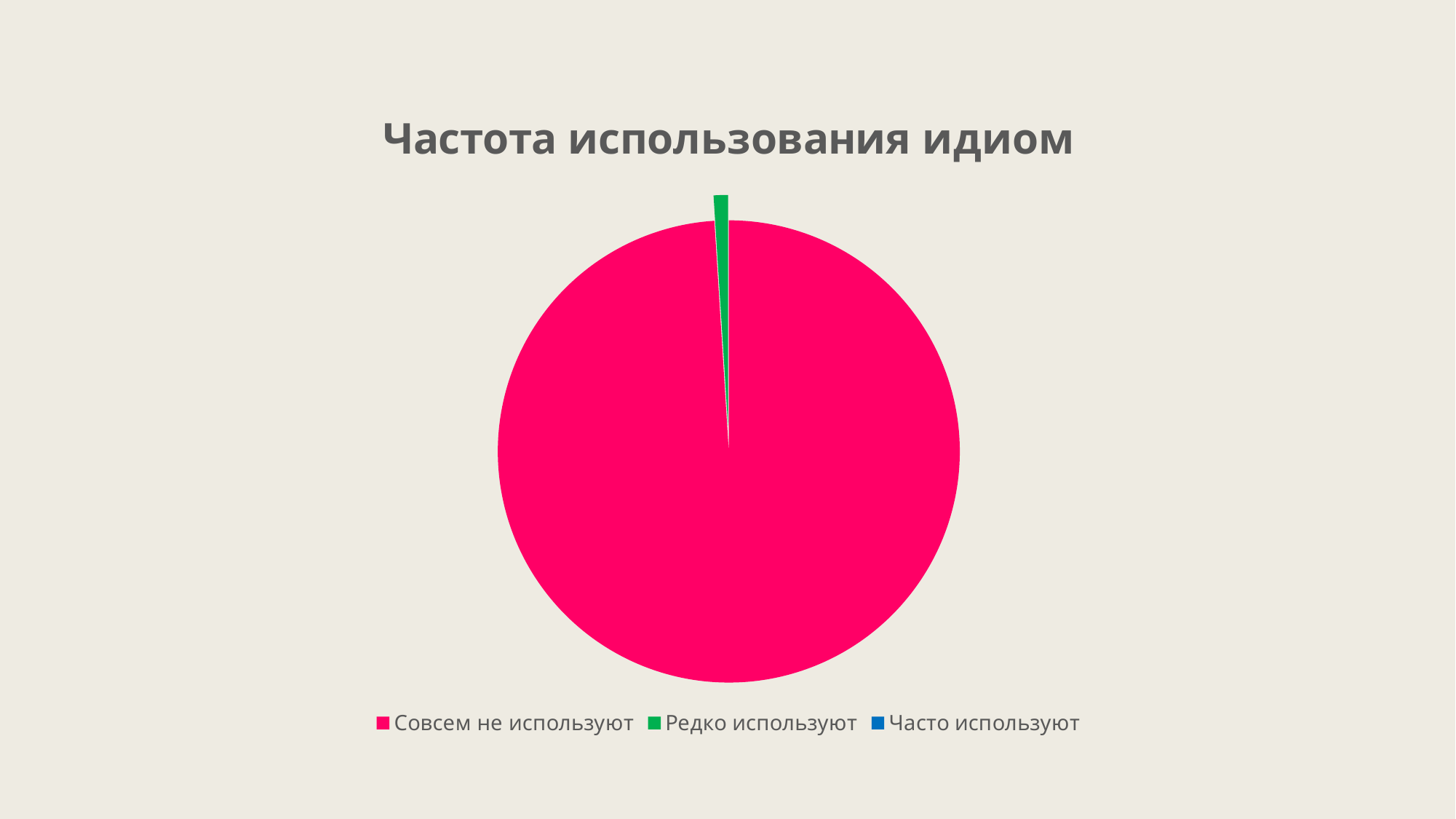
Which is larger: the slice for "Совсем не используют" or the slice for "Редко используют"? Совсем не используют Is the share of the pie for "Редко используют" greater or less than 10%? less What kind of chart is shown on the slide? pie chart Which category has the largest slice of the pie? Совсем не используют Which category is represented by the pink slice of the pie? Совсем не используют Which colour represents "Редко используют" in the pie chart? green What is the title of the chart? Частота использования идиом How many categories does the legend of the pie chart list? 3 Is the share of the pie for "Совсем не используют" greater or less than 50%? greater